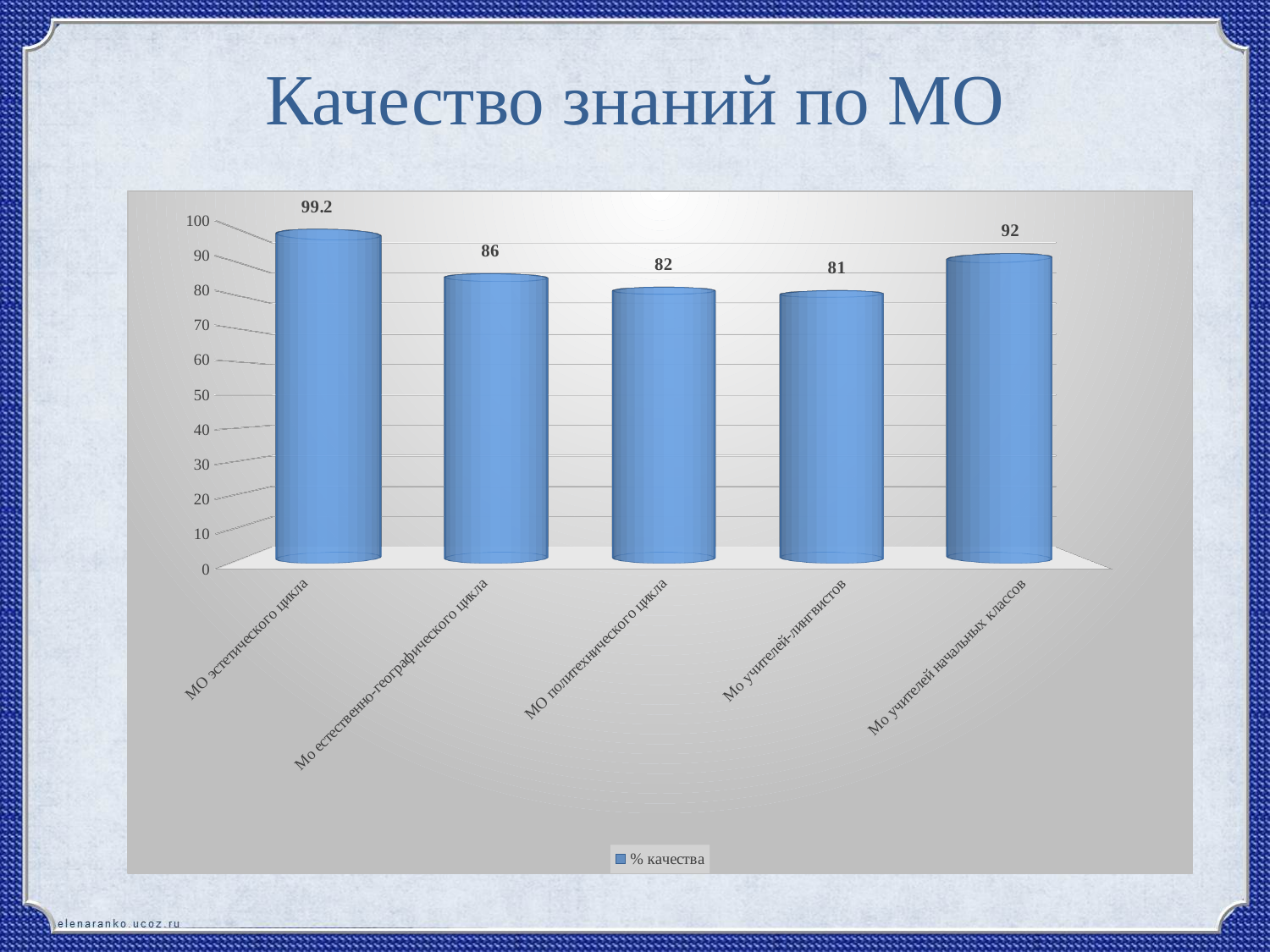
What is the difference between the values for Мо учителей начальных классов and Мо естественно-географического цикла? 6 Which category has the lowest value? Мо учителей-лингвистов What is the difference between the values for МО эстетического цикла and Мо учителей-лингвистов? 18.2 What is the title of the slide? Качество знаний по МО What is the value for МО эстетического цикла? 99.2 What is the value for Мо учителей начальных классов? 92 Which category has the highest value? МО эстетического цикла Which is larger, the value for Мо естественно-географического цикла or the value for Мо учителей начальных классов? Мо учителей начальных классов How many series does the legend list? 1 What is the value for МО политехнического цикла? 82 How many categories are shown on the chart? 5 What kind of chart is shown on the slide? bar chart